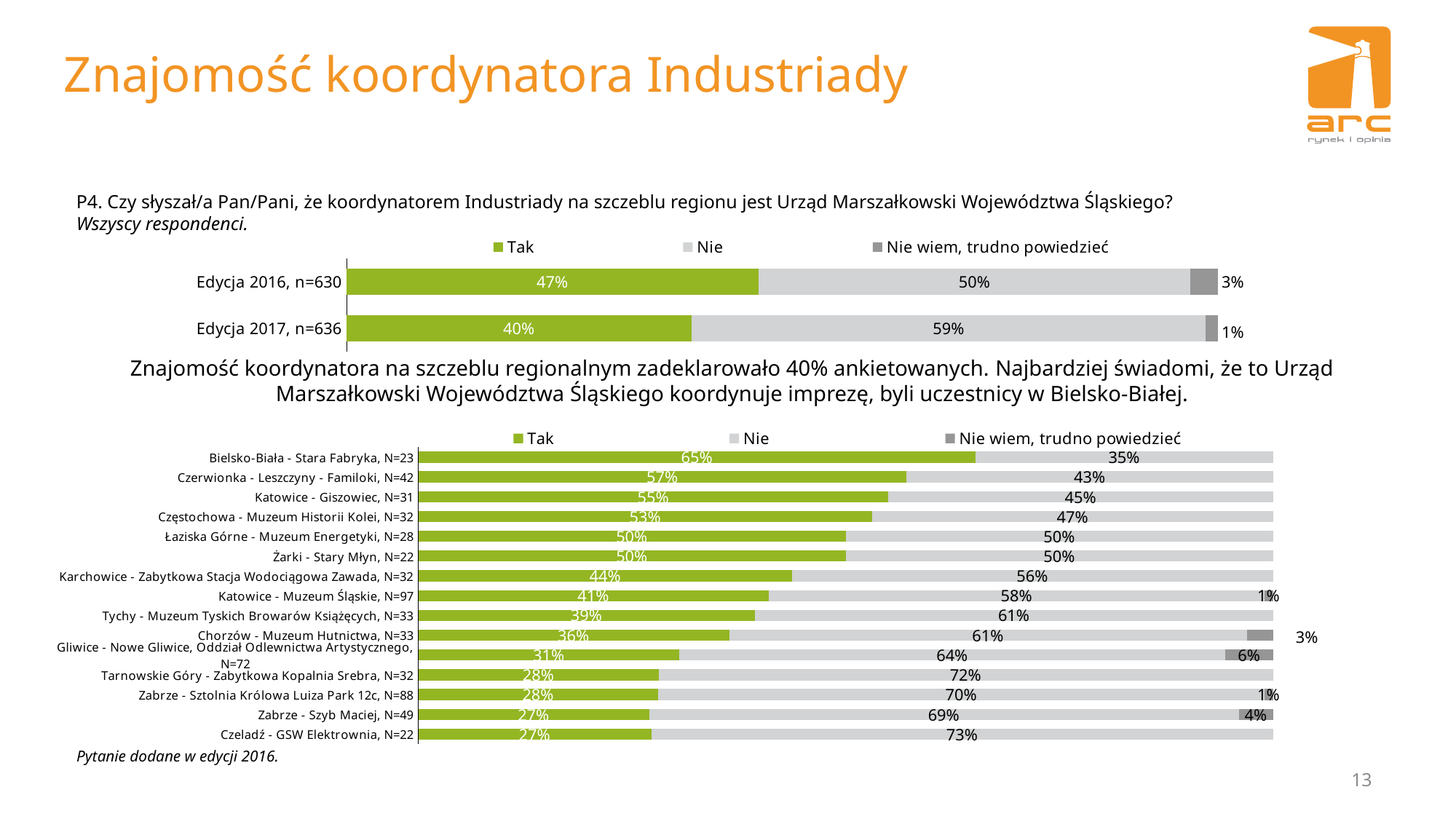
In the bottom chart, what is the 'Tak' value for Chorzów - Muzeum Hutnictwa, N=33? 36% In the top chart (Edycja 2016 / Edycja 2017), what is the 'Tak' value for Edycja 2017, n=636? 40% In the bottom chart, what is the 'Nie' value for Czeladź - GSW Elektrownia, N=22? 73% In the bottom chart (by location), which location has the highest 'Tak' value? Bielsko-Biała - Stara Fabryka, N=23 In the top chart, how many series does the legend list? 3 In the bottom chart, which is larger: the 'Tak' value for Katowice - Giszowiec, N=31 or for Tychy - Muzeum Tyskich Browarów Książęcych, N=33? Katowice - Giszowiec, N=31 In the bottom chart, what is the difference between the 'Nie' values for Tarnowskie Góry - Zabytkowa Kopalnia Srebra, N=32 and Bielsko-Biała - Stara Fabryka, N=23? 37 percentage points What type of chart is the bottom chart? Stacked bar chart In the top chart, what is the 'Nie' value for Edycja 2016, n=630? 50% In the bottom chart, how many locations are listed? 15 In the top chart, what is the difference between the 'Tak' values for Edycja 2016 and Edycja 2017? 7 percentage points In the bottom chart, what is the 'Nie wiem, trudno powiedzieć' value for Gliwice - Nowe Gliwice, Oddział Odlewnictwa Artystycznego, N=72? 6%